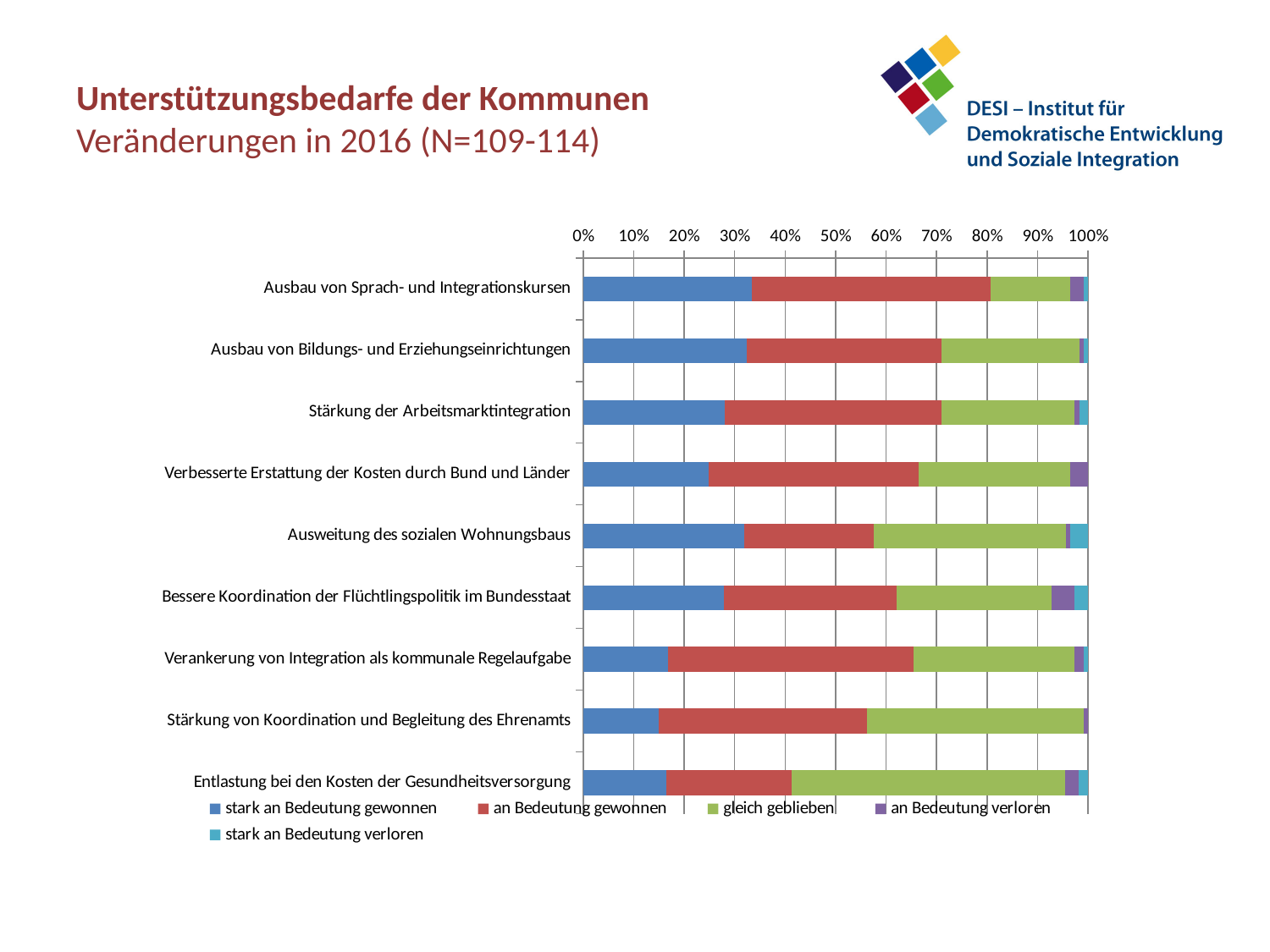
Which has the larger 'an Bedeutung gewonnen' share: 'Ausbau von Sprach- und Integrationskursen' or 'Entlastung bei den Kosten der Gesundheitsversorgung'? Ausbau von Sprach- und Integrationskursen What kind of chart is shown on the slide? Stacked bar chart Is the 'stark an Bedeutung gewonnen' share for 'Stärkung von Koordination und Begleitung des Ehrenamts' greater or less than 20%? less How many categories (support needs) are plotted on the chart? 9 Which category has the largest 'gleich geblieben' share? Entlastung bei den Kosten der Gesundheitsversorgung What colour represents the series 'gleich geblieben' in the legend? Green Which category has the smallest 'an Bedeutung gewonnen' share? Entlastung bei den Kosten der Gesundheitsversorgung Is the 'stark an Bedeutung gewonnen' share for 'Ausweitung des sozialen Wohnungsbaus' greater or less than 20%? greater What is the title of the slide containing the chart? Unterstützungsbedarfe der Kommunen – Veränderungen in 2016 (N=109-114) How many series does the legend list? 5 Is the 'stark an Bedeutung gewonnen' share for 'Ausbau von Sprach- und Integrationskursen' greater or less than 20%? greater Which has the larger 'gleich geblieben' share: 'Entlastung bei den Kosten der Gesundheitsversorgung' or 'Ausbau von Bildungs- und Erziehungseinrichtungen'? Entlastung bei den Kosten der Gesundheitsversorgung